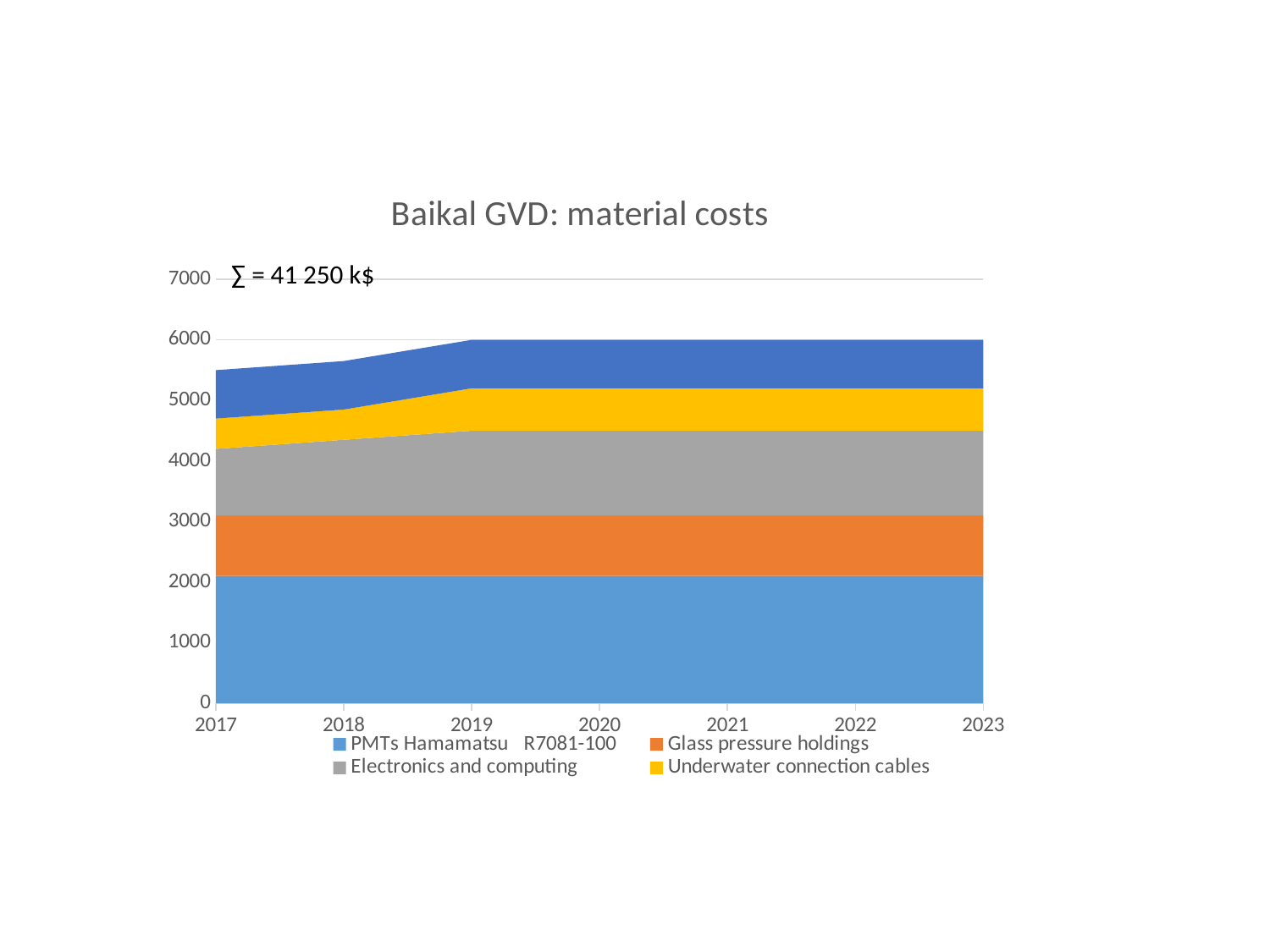
Does the total stacked value rise or fall from 2017 to 2019? rise Is the total stacked value for 2017 greater or less than 6000? less Is the value for PMTs Hamamatsu R7081-100 in 2020 greater or less than 1000? greater What kind of chart is shown on the slide? stacked area chart What total sum is annotated at the top of the chart? ∑ = 41 250 k$ Which legend series occupies the largest area of the chart? PMTs Hamamatsu R7081-100 How many series does the chart's legend list? 4 How many years are shown along the x axis of the chart? 7 What is the title of the chart? Baikal GVD: material costs Which legend series occupies the smallest area of the chart? Underwater connection cables Which is larger in 2021, the value for Glass pressure holdings or the value for Underwater connection cables? Glass pressure holdings Is the total stacked value for 2017 greater or less than 5000? greater